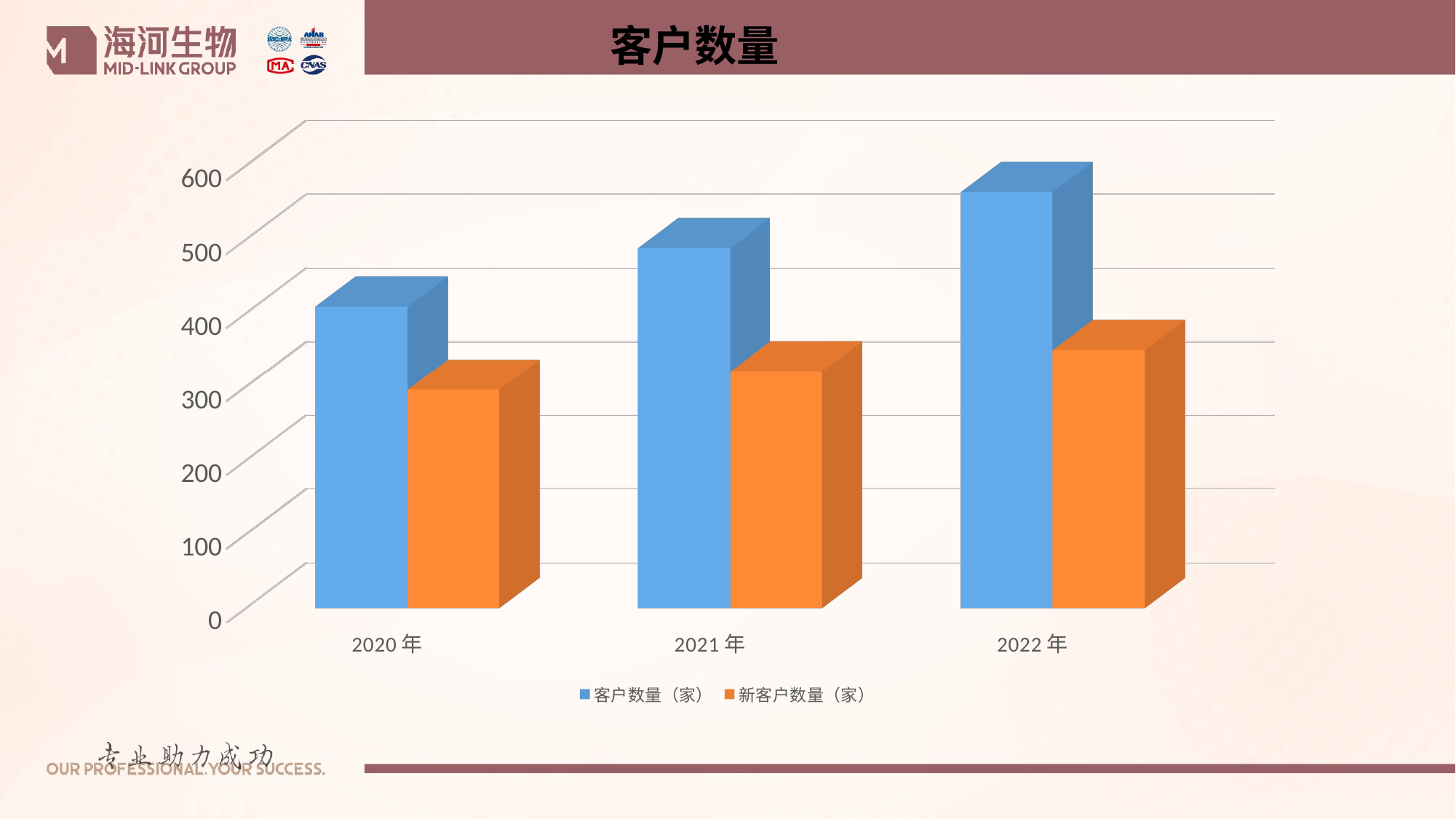
In which year is 客户数量（家） highest? 2022年 Is the value of 新客户数量（家） for 2021年 greater or less than 400? less Which series is shown in orange? 新客户数量（家） What kind of chart is shown on the slide? bar chart How many year categories are shown on the x axis? 3 Does the value of 客户数量（家） rise or fall from 2020年 to 2022年? rise In 2021年, which is larger: 客户数量（家） or 新客户数量（家）? 客户数量（家） What is the title of the chart? 客户数量 Is the value of 客户数量（家） for 2021年 greater or less than 400? greater Is the value of 客户数量（家） for 2022年 greater or less than 500? greater How many series does the legend list? 2 In which year is 新客户数量（家） lowest? 2020年